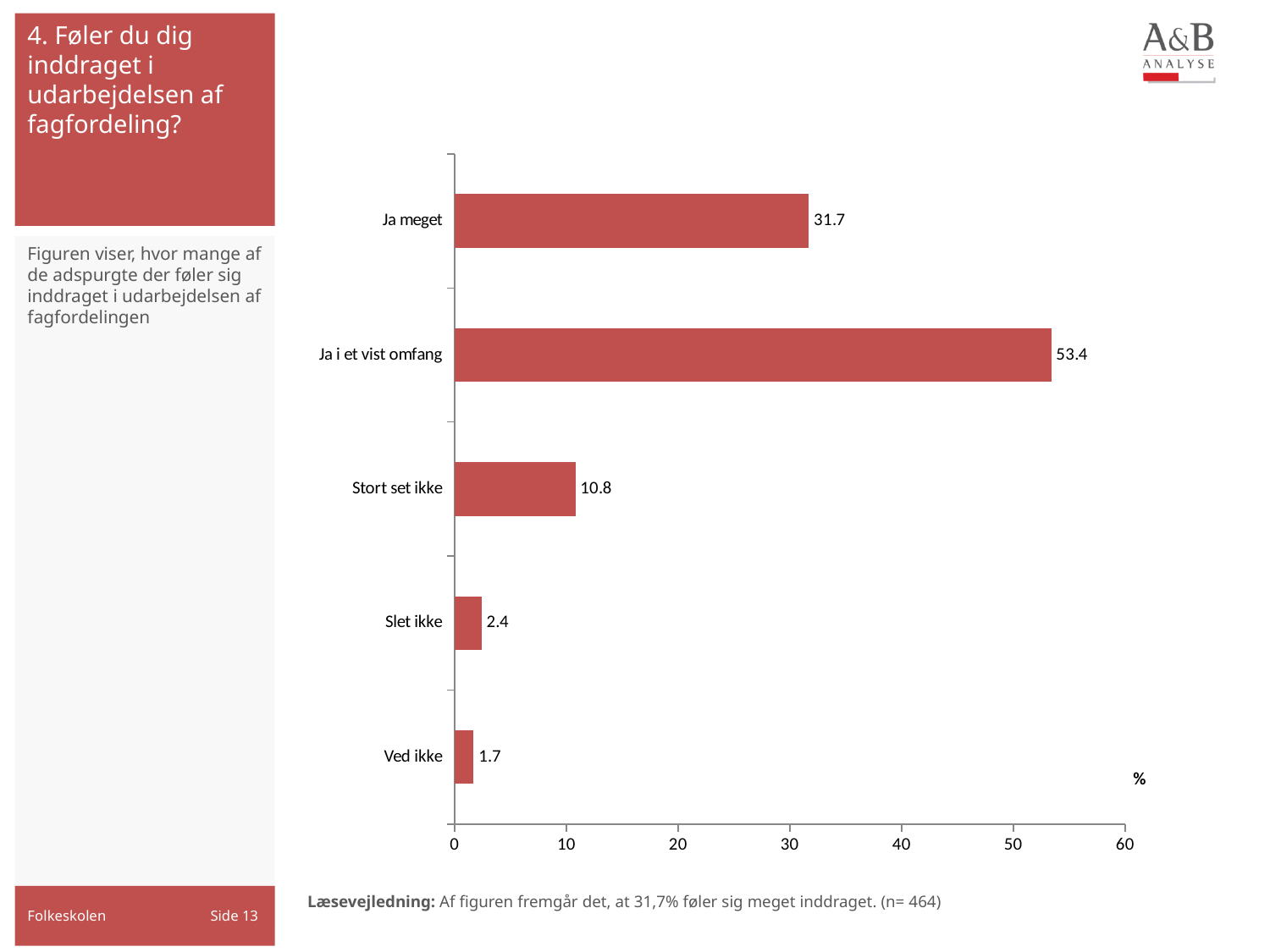
Which category has the highest value? Ja i et vist omfang What is the value for "Stort set ikke"? 10.8 How many categories are shown in the chart? 5 What kind of chart is shown on the slide? bar chart What is the value for "Ja meget"? 31.7 What is the value for "Slet ikke"? 2.4 What is the difference between the values for "Ja i et vist omfang" and "Ja meget"? 21.7 Which is larger, the value for "Stort set ikke" or the value for "Slet ikke"? Stort set ikke Is the value for "Ja meget" greater or less than 30? greater Which category has the lowest value? Ved ikke What is the value for "Ved ikke"? 1.7 What is the value for "Ja i et vist omfang"? 53.4